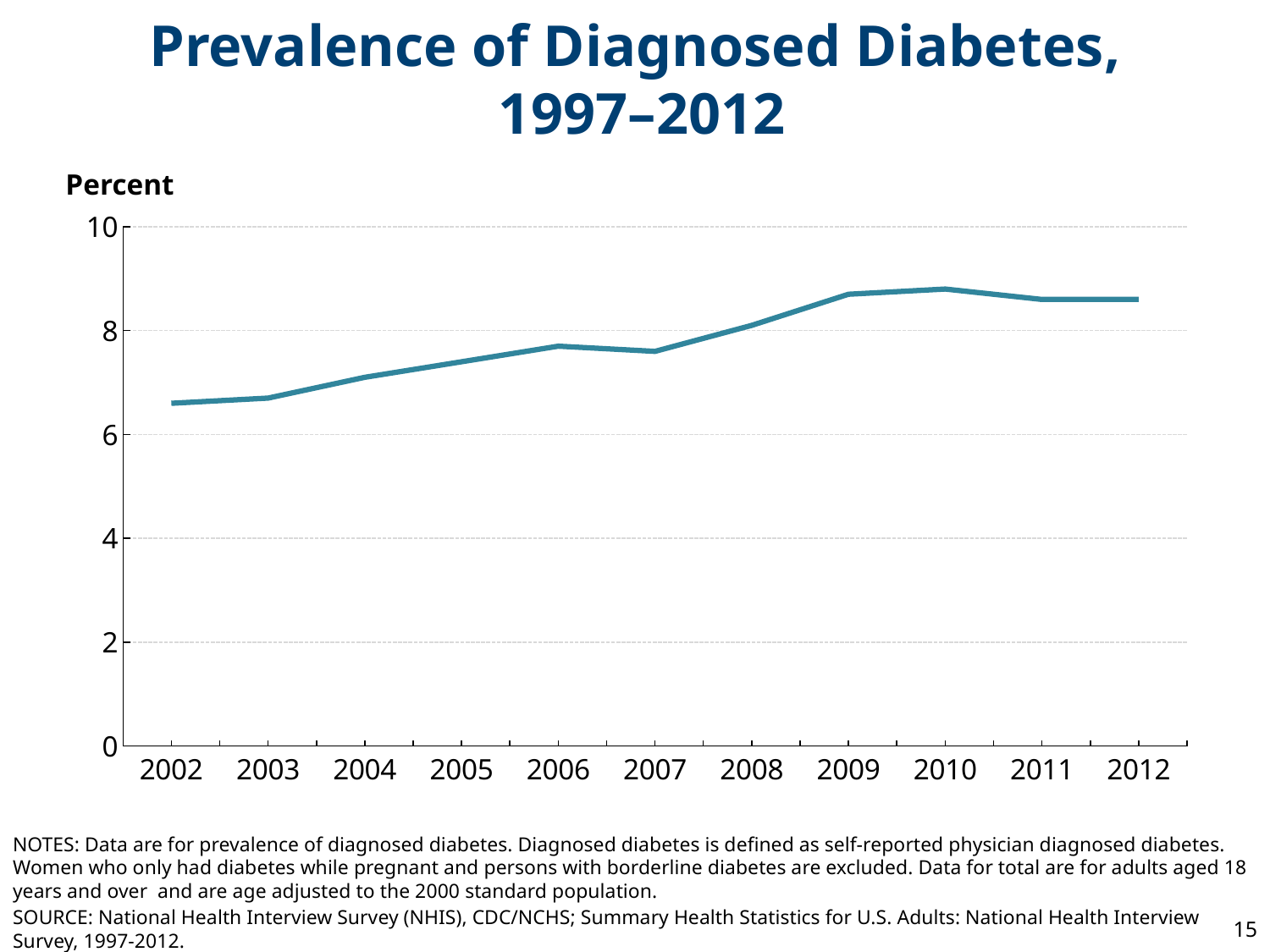
Is the value for 2004 greater or less than 8? less Which year has the larger value, 2004 or 2008? 2008 What is the label on the y axis? Percent Is the value for 2012 greater or less than 8? greater What kind of chart is shown on the slide? line chart Is the value for 2009 greater or less than 8? greater Overall, does the prevalence rise or fall from 2002 to 2012? rise What is the title of the chart? Prevalence of Diagnosed Diabetes, 1997–2012 Which year has the larger value, 2002 or 2012? 2012 How many years are plotted along the x axis? 11